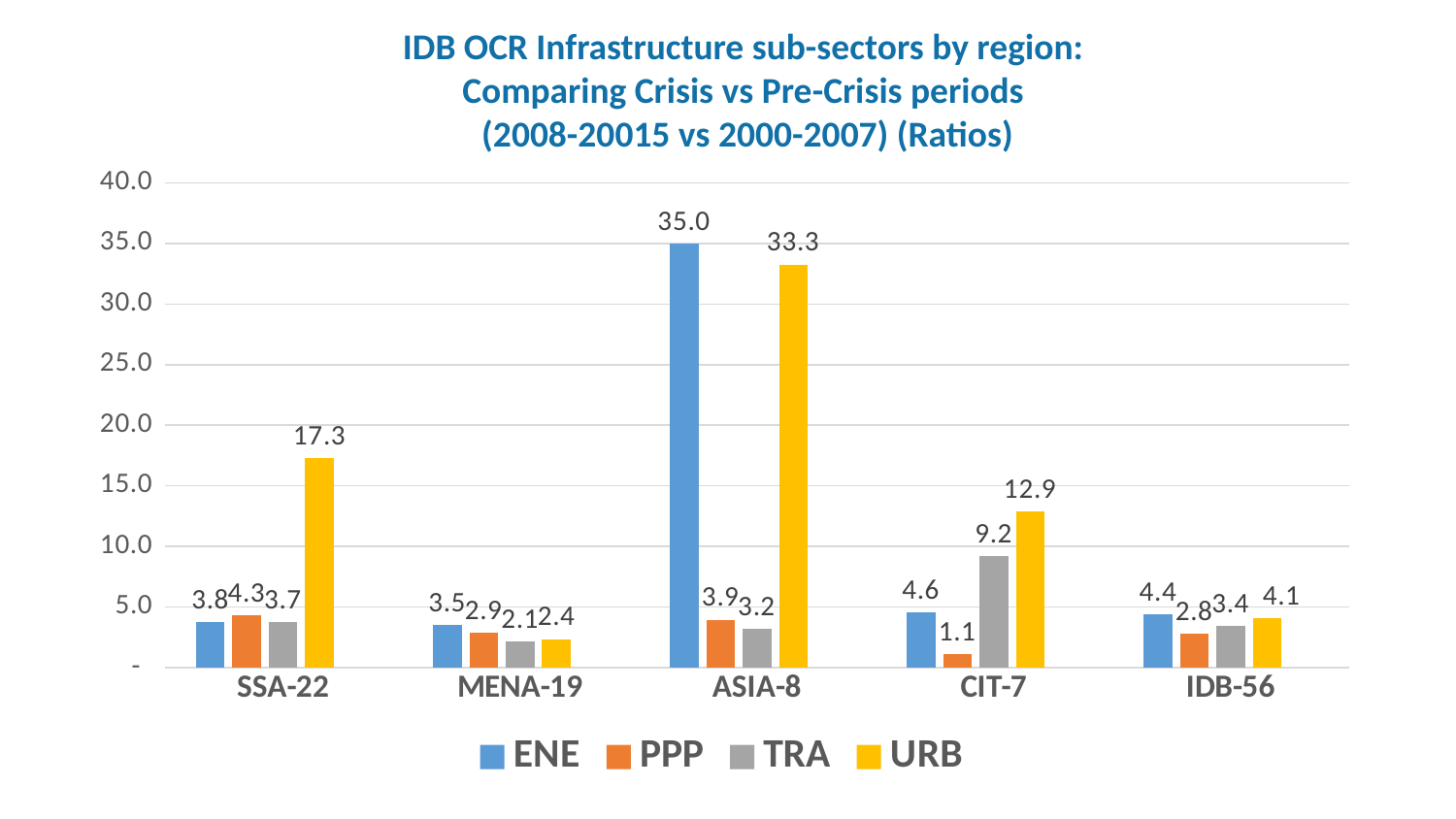
How many series does the legend list? 4 Is the URB value for ASIA-8 greater or less than 30.0? greater What kind of chart is shown on the slide? Bar chart What is the TRA value for MENA-19? 2.1 How many regions are shown on the x axis? 5 What is the difference between the ENE and URB values for ASIA-8? 1.7 What is the URB value for SSA-22? 17.3 Which is larger for CIT-7, the TRA value or the URB value? URB Which region has the highest ENE value? ASIA-8 What is the PPP value for CIT-7? 1.1 What is the ENE value for ASIA-8? 35.0 Which region has the lowest PPP value? CIT-7